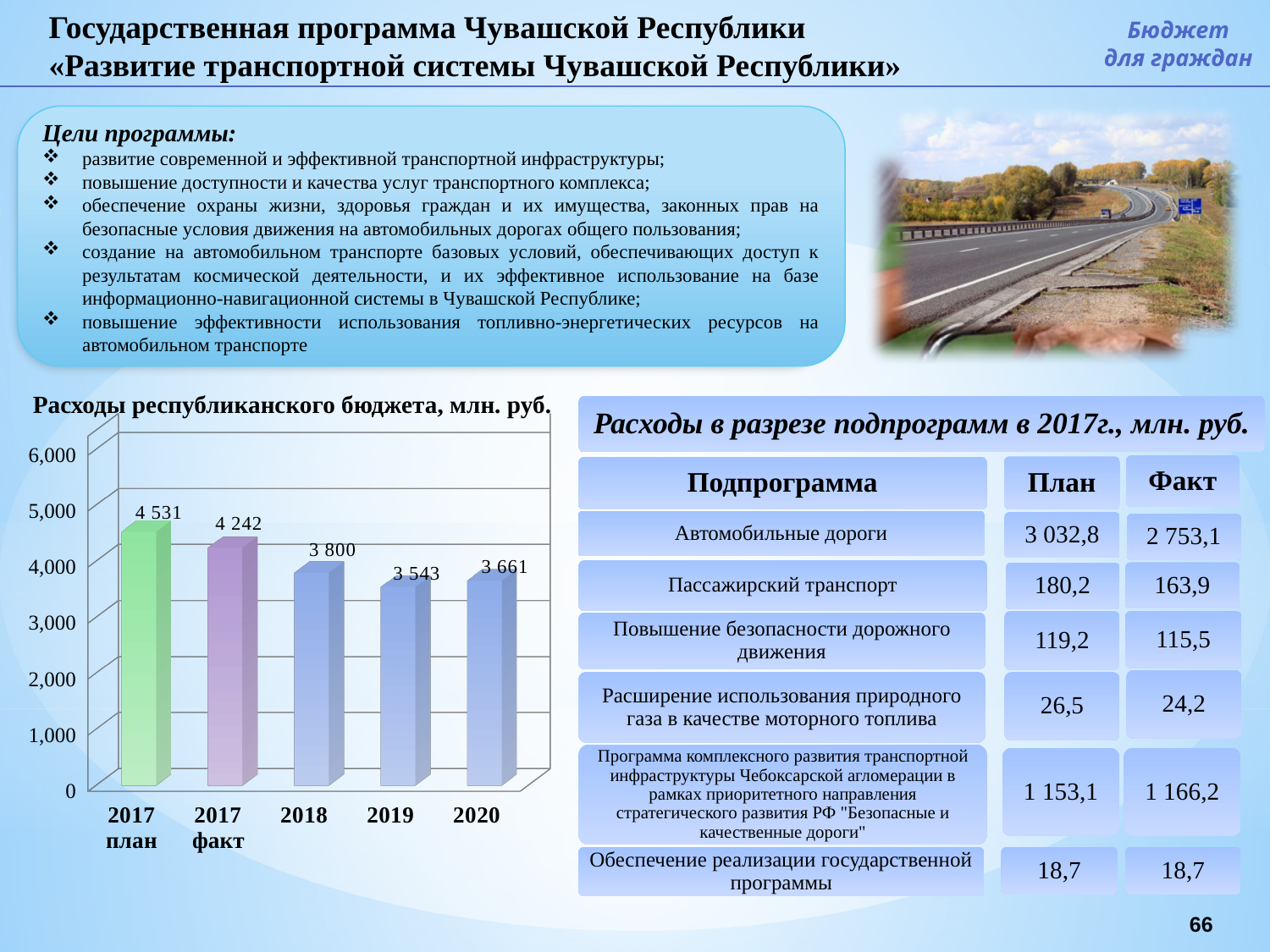
What is the title of the chart on the slide? Расходы республиканского бюджета, млн. руб. What is the value for 2017 факт in the chart? 4 242 Which category has the lowest value in the chart? 2019 What kind of chart is shown on the slide? Bar chart What is the difference between the 2017 план and 2017 факт values? 289 Which is larger, the value for 2019 or the value for 2020? 2020 Which category has the highest value in the chart? 2017 план What is the value for 2018 in the chart? 3 800 What is the value for 2019 in the chart? 3 543 What is the value for 2017 план in the chart 'Расходы республиканского бюджета, млн. руб.'? 4 531 What is the value for 2020 in the chart? 3 661 How many bars are shown in the chart? 5